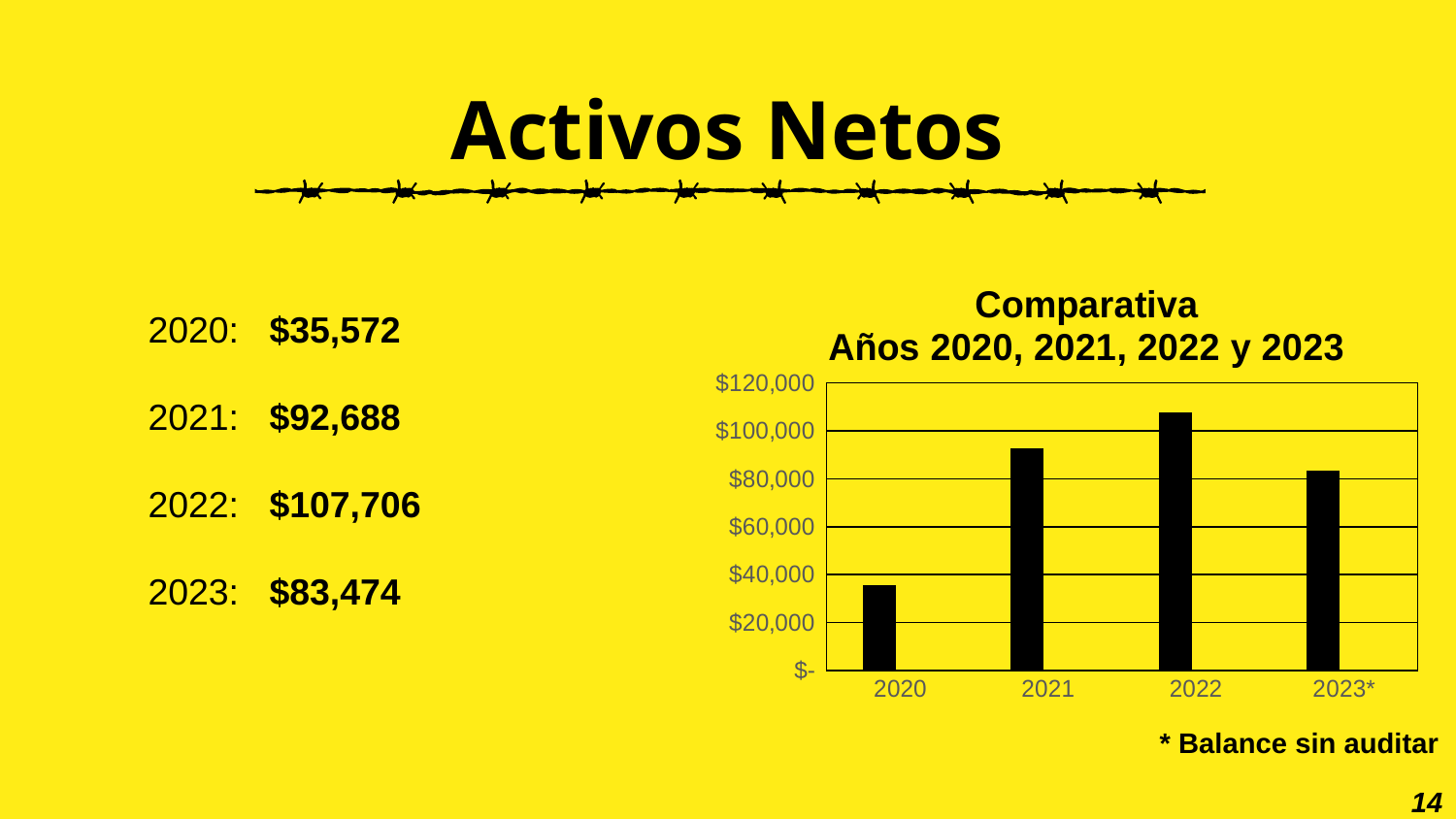
Which year has the lowest value in the chart? 2020 Which year has the highest value in the chart? 2022 What is the difference between the values for 2022 and 2021? $15,018 Is the value for 2020 greater or less than $40,000? less What is the value for 2022? $107,706 Which is larger, the value for 2021 or the value for 2023? 2021 Is the value for 2022 greater or less than $100,000? greater What is the title of the chart? Comparativa Años 2020, 2021, 2022 y 2023 What is the value for 2020? $35,572 Does the value rise or fall from 2022 to 2023? fall What type of chart is shown on the slide? bar chart How many years (bars) are plotted in the chart? 4